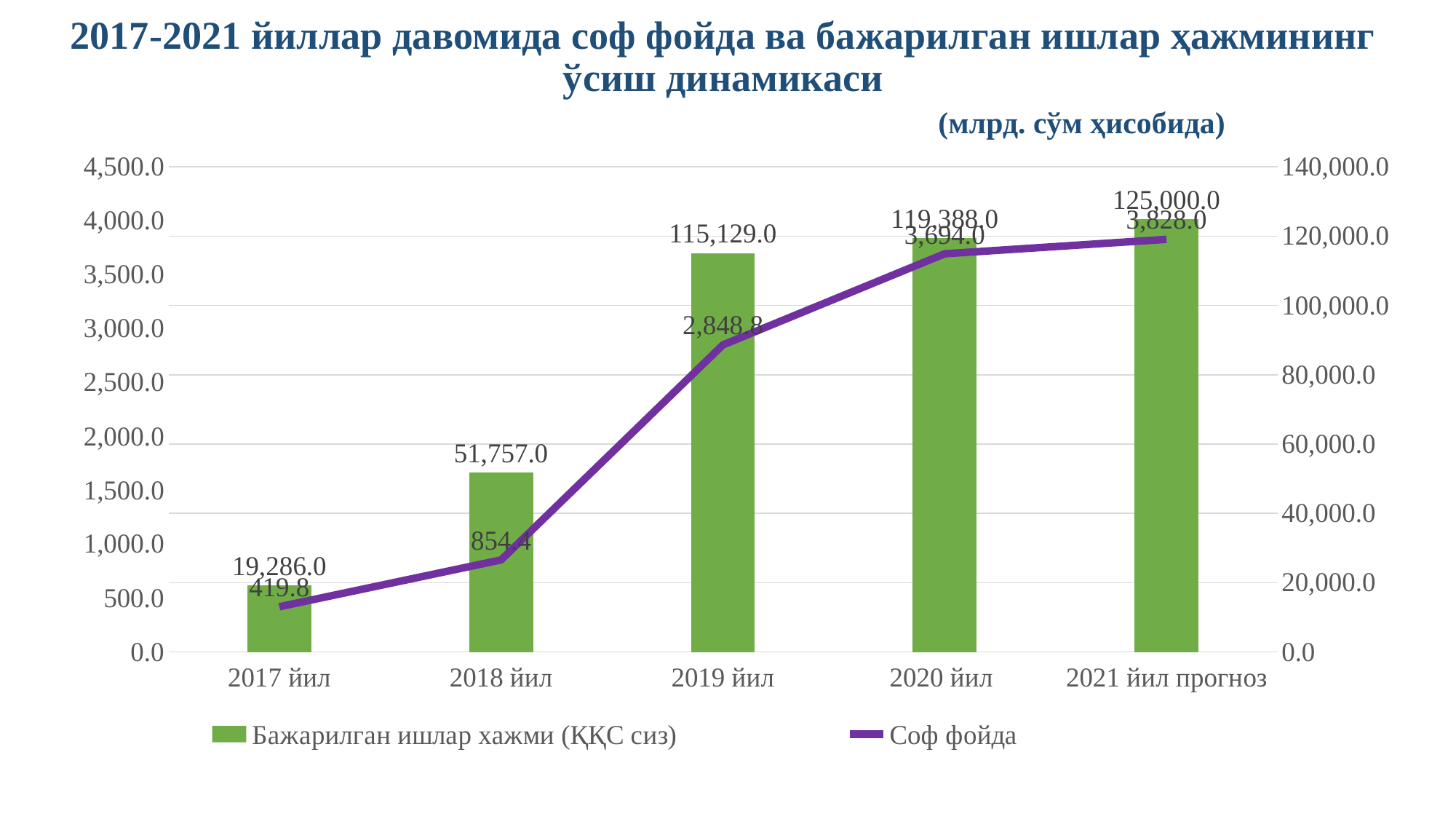
What is the value of Бажарилган ишлар хажми (ҚҚС сиз) for 2021 йил прогноз? 125,000.0 What is the value of Соф фойда for 2017 йил? 419.8 What is the value of Соф фойда for 2018 йил? 854.4 Which is larger, the Соф фойда value for 2019 йил or for 2018 йил? 2019 йил What is the value of Бажарилган ишлар хажми (ҚҚС сиз) for 2019 йил? 115,129.0 What is the difference between the Бажарилган ишлар хажми (ҚҚС сиз) values for 2018 йил and 2017 йил? 32,471.0 What colour are the bars for Бажарилган ишлар хажми (ҚҚС сиз)? green How many categories are shown on the x axis? 5 Does the Соф фойда line rise or fall from 2017 йил to 2021 йил прогноз? rise Which year has the lowest value of Бажарилган ишлар хажми (ҚҚС сиз)? 2017 йил Which year has the highest value of Соф фойда? 2021 йил прогноз How many series does the legend list? 2